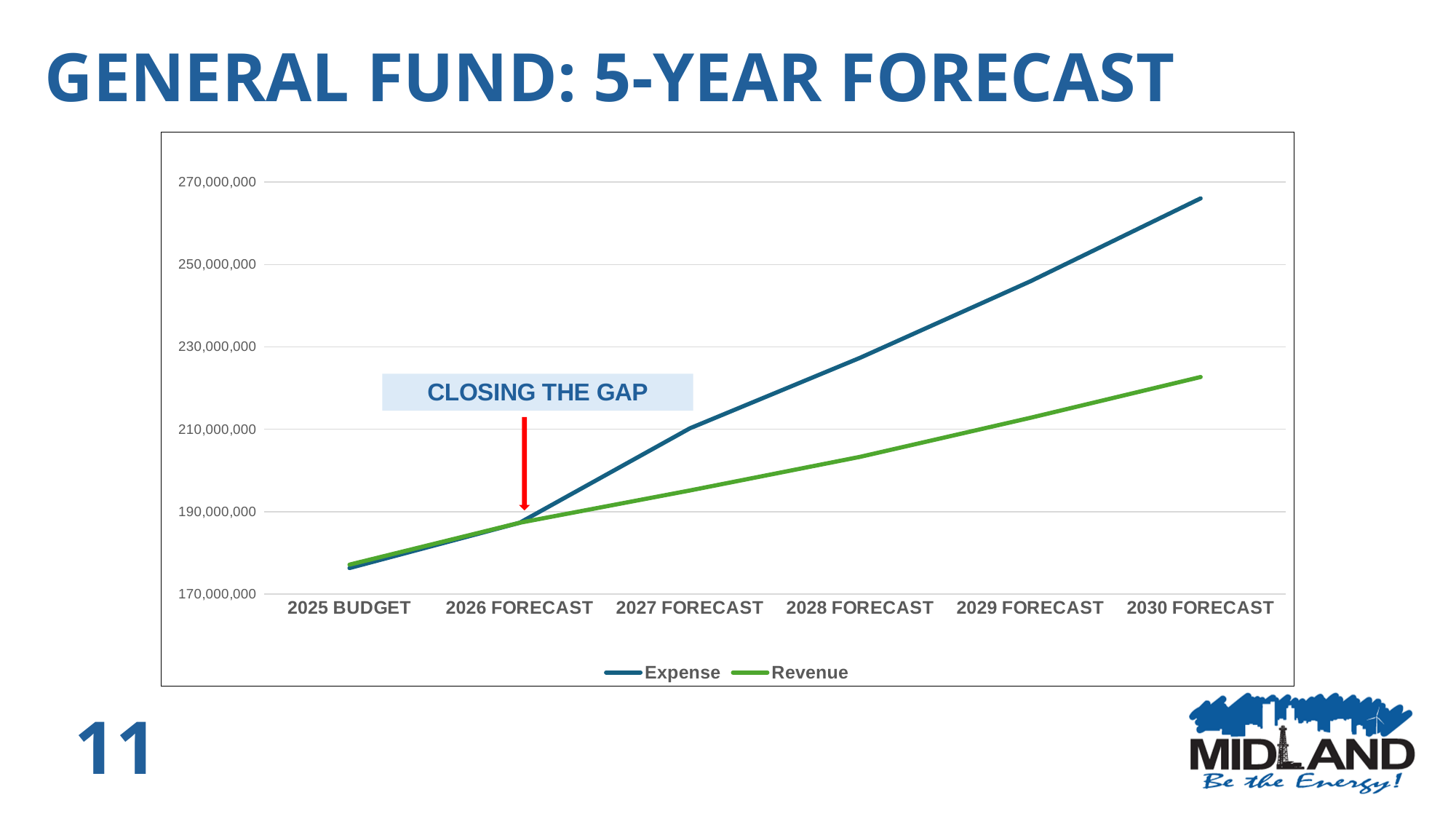
What kind of chart is shown on the slide? Line chart How many series does the legend list? 2 What are the two series named in the legend? Expense and Revenue What text appears in the annotation box above the red arrow on the chart? CLOSING THE GAP Is the Revenue value for 2028 FORECAST greater or less than 190,000,000? greater Do the Expense values rise or fall from 2025 BUDGET to 2030 FORECAST? Rise How many categories are shown along the x axis? 6 Is the Revenue value for 2030 FORECAST greater or less than 210,000,000? greater Is the Revenue value for 2025 BUDGET greater or less than 190,000,000? less Which series is larger in 2030 FORECAST, Expense or Revenue? Expense